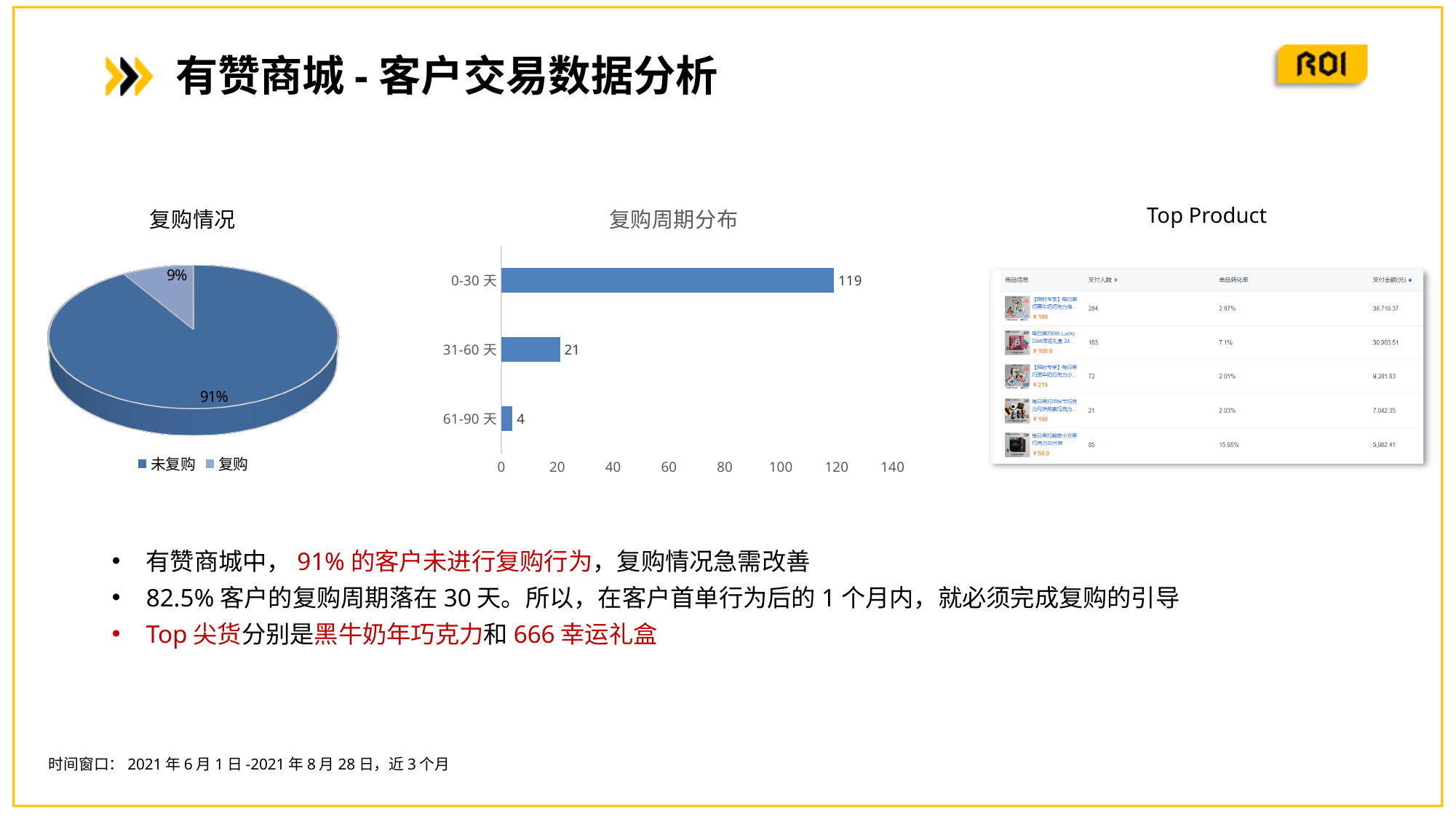
In the '复购周期分布' chart, what is the value for 0-30 天? 119 What kind of chart is '复购周期分布'? bar chart In the '复购情况' pie chart, what share of customers are 复购? 9% In the '复购周期分布' chart, which category has the lowest value? 61-90 天 In the '复购周期分布' chart, what is the value for 61-90 天? 4 What kind of chart is '复购情况'? pie chart In the '复购周期分布' chart, what is the difference between the values for 0-30 天 and 31-60 天? 98 In the '复购周期分布' chart, what is the value for 31-60 天? 21 How many entries does the legend of the '复购情况' pie chart list? 2 In the '复购周期分布' chart, which category has the highest value? 0-30 天 In the '复购情况' pie chart, what share of customers are 未复购? 91% How many categories are shown in the '复购周期分布' chart? 3